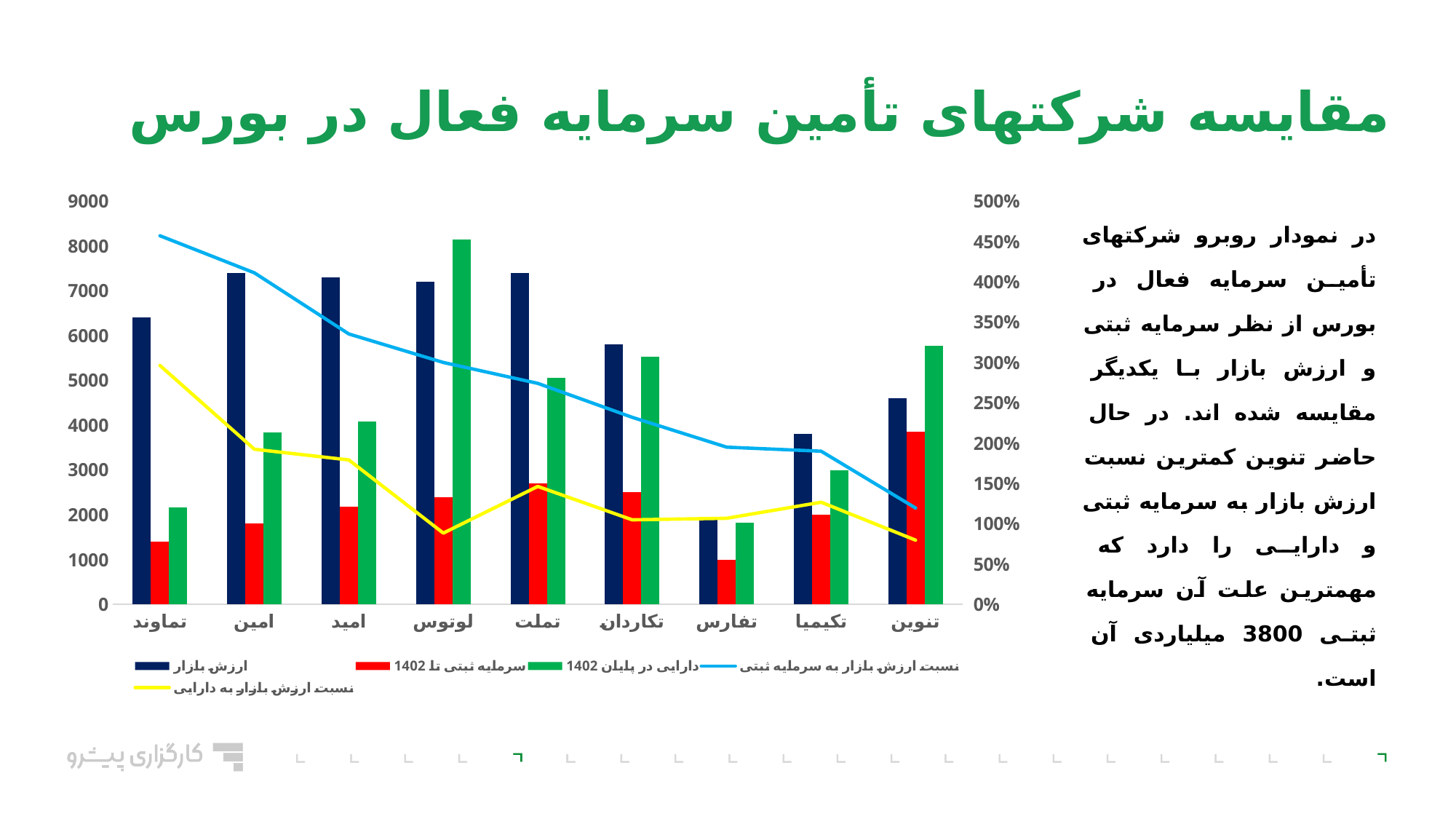
How many companies (categories) are shown on the x axis of the chart? 9 Which company has the lowest value for ارزش بازار (navy bars)? تفارس Which company has the highest value for دارایی در پایان 1402 (green bars)? لوتوس Which has the larger ارزش بازار value, تماوند or امید? امید Does the نسبت ارزش بازار به سرمایه ثبتی line generally rise or fall from تماوند to تنوین? fall Is the نسبت ارزش بازار به سرمایه ثبتی value for تماوند greater or less than 400%? greater Is the دارایی در پایان 1402 value for لوتوس greater or less than 8000? greater What kind of chart is shown on the slide? Combination bar and line chart What colour is the line for نسبت ارزش بازار به دارایی in the chart? Yellow Which company has the highest value for سرمایه ثبتی تا 1402 (red bars)? تنوین How many series does the chart legend list? 5 Is the ارزش بازار value for تماوند greater or less than 6000? greater